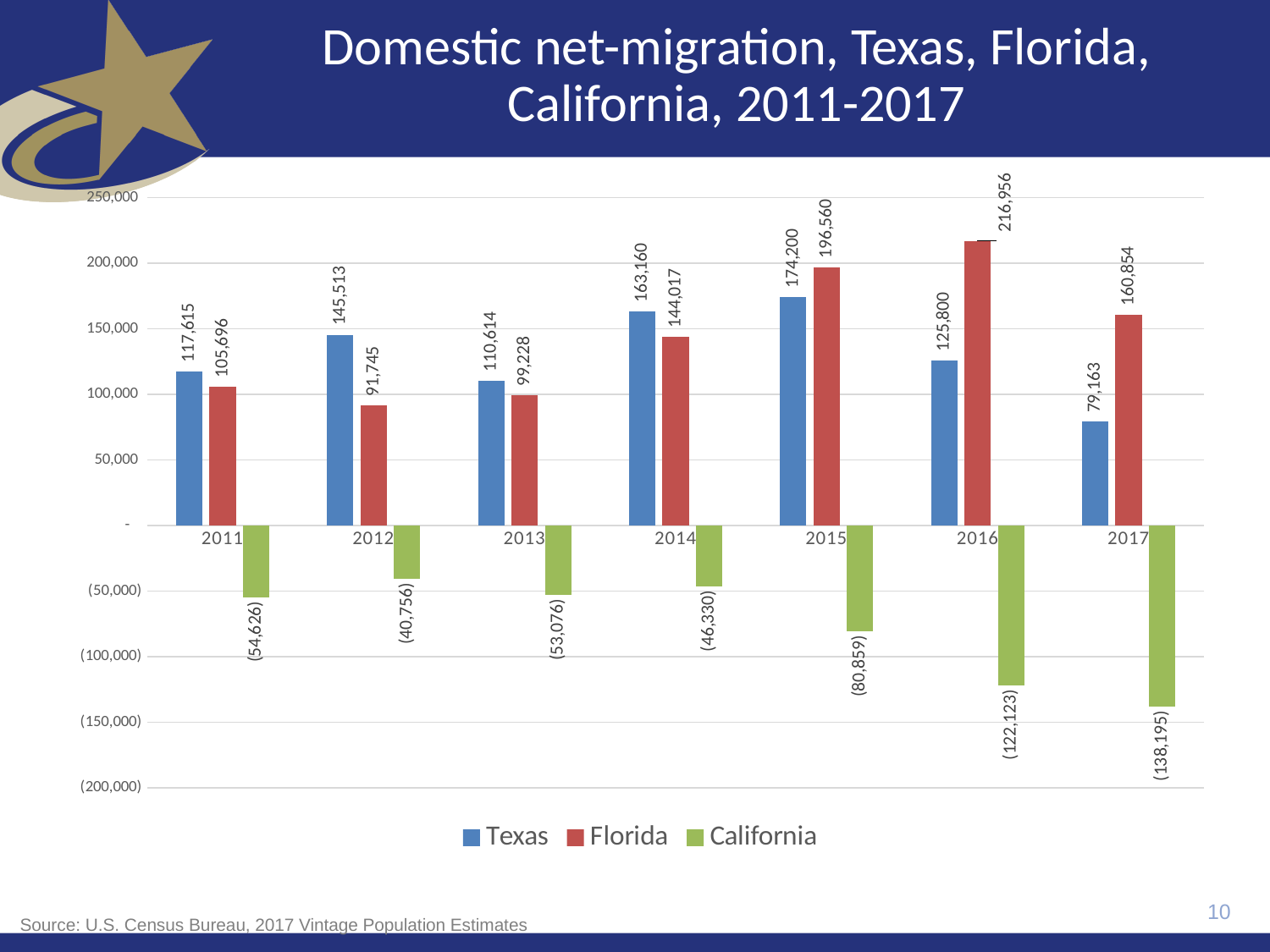
In which year is the Texas value lowest? 2017 How many years are shown on the x axis? 7 How many series does the legend list? 3 Which is larger in 2012, the Texas value or the Florida value? Texas Which colour represents California in the chart? green In which year is the Texas value highest? 2015 What kind of chart is shown on the slide? bar chart What is the domestic net-migration value for California in 2017? (138,195) What is the difference between the Florida and Texas values in 2017? 81,691 Is the Florida value for 2015 greater or less than 150,000? greater What is the domestic net-migration value for Texas in 2015? 174,200 What is the domestic net-migration value for Florida in 2016? 216,956